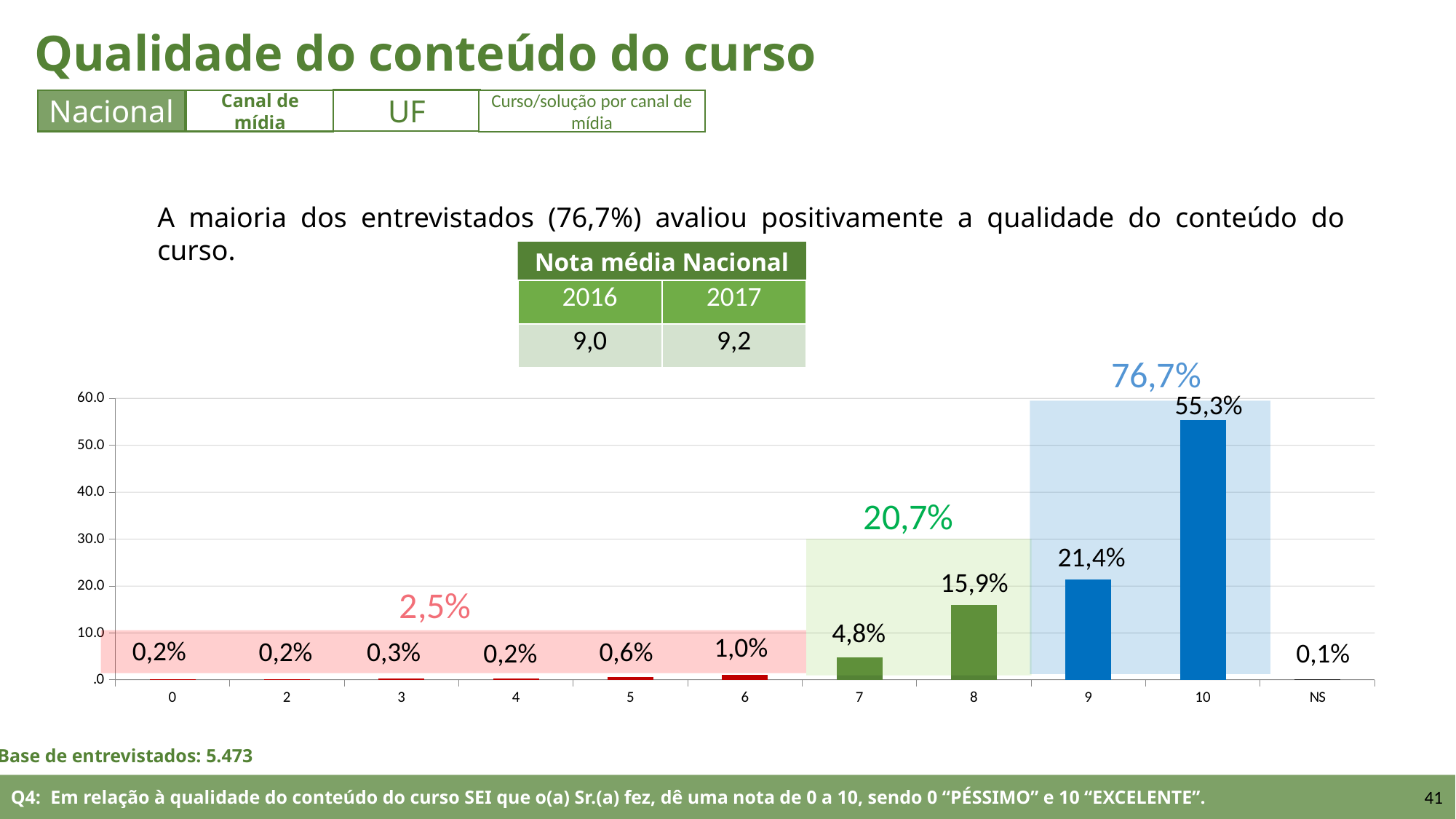
What percentage is shown above the blue highlighted region covering scores 9 and 10? 76,7% Which category has the highest value? 10 What is the value for the NS category? 0,1% What is the value for score 7? 4,8% What kind of chart is shown on the slide? bar chart How many categories are shown on the x axis? 11 Is the value for score 10 greater or less than 50.0? greater What is the value for score 8? 15,9% What is the difference between the values for score 10 and score 9? 33,9% Which category has the lowest value? NS Which is larger, the value for score 8 or the value for score 9? 9 What is the value for score 10? 55,3%